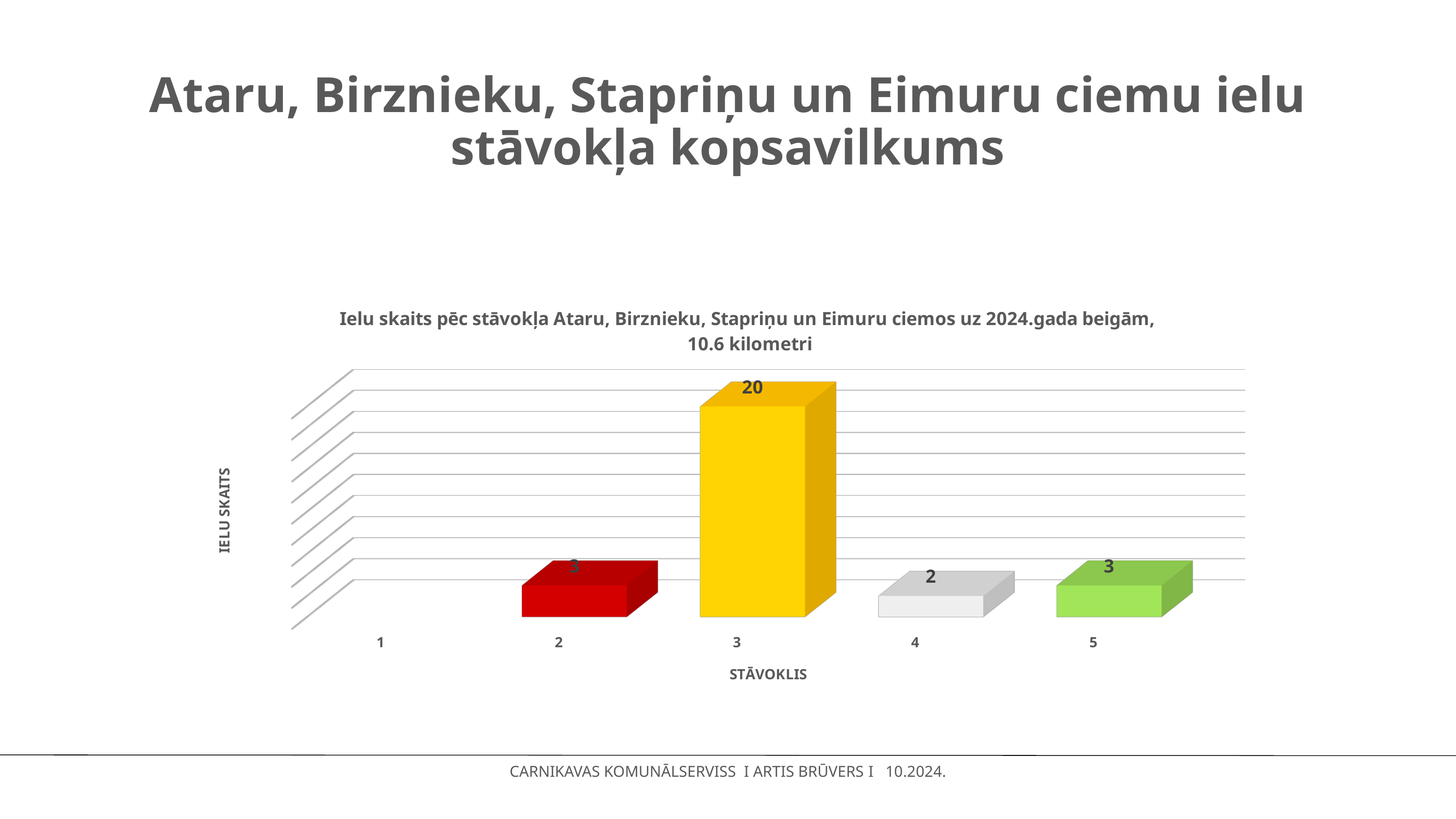
What is the difference between the values for category 3 and category 2? 17 Which is larger, the value for category 3 or the value for category 4? category 3 How many categories are shown on the x axis? 5 What kind of chart is shown on the slide? bar chart What is the difference between the values for category 5 and category 4? 1 What is the value for category 4? 2 What is the value for category 3? 20 What is the label of the x axis? STĀVOKLIS What is the value for category 5? 3 Which category has the highest value? 3 What colour is the bar for category 3? yellow What is the value for category 2? 3